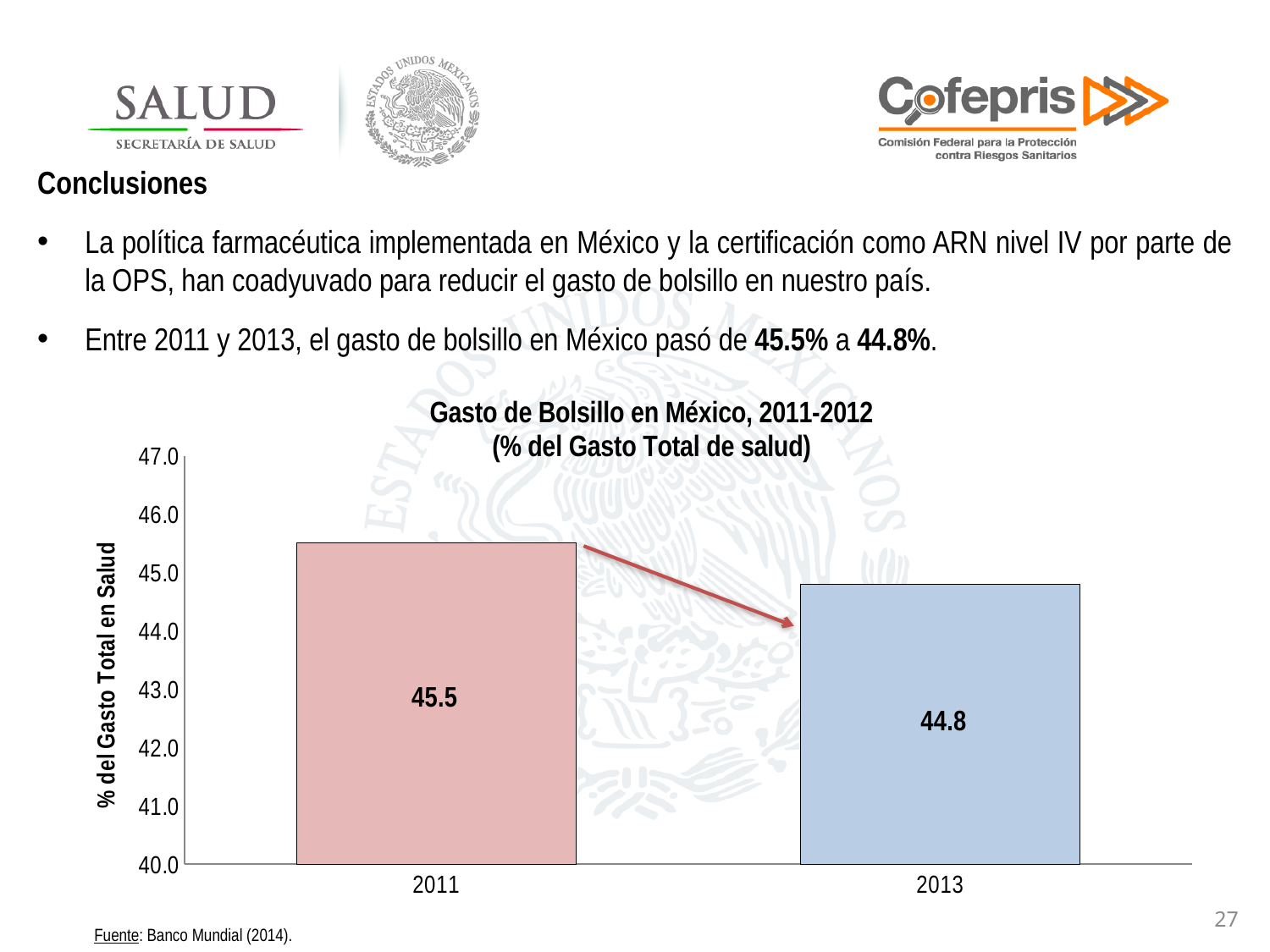
Is the value for 2011 greater or less than 45.0? greater What is the label of the vertical axis of the chart? % del Gasto Total en Salud How many bars are plotted in the chart? 2 What is the value for 2013 in the chart? 44.8 Which year has the lowest value in the chart? 2013 Which year has the highest value in the chart? 2011 What is the difference between the values for 2011 and 2013? 0.7 Which is larger, the value for 2011 or the value for 2013? 2011 Is the value for 2013 greater or less than 45.0? less Do the values rise or fall from 2011 to 2013? fall What kind of chart is shown on the slide? bar chart What is the value for 2011 in the chart? 45.5